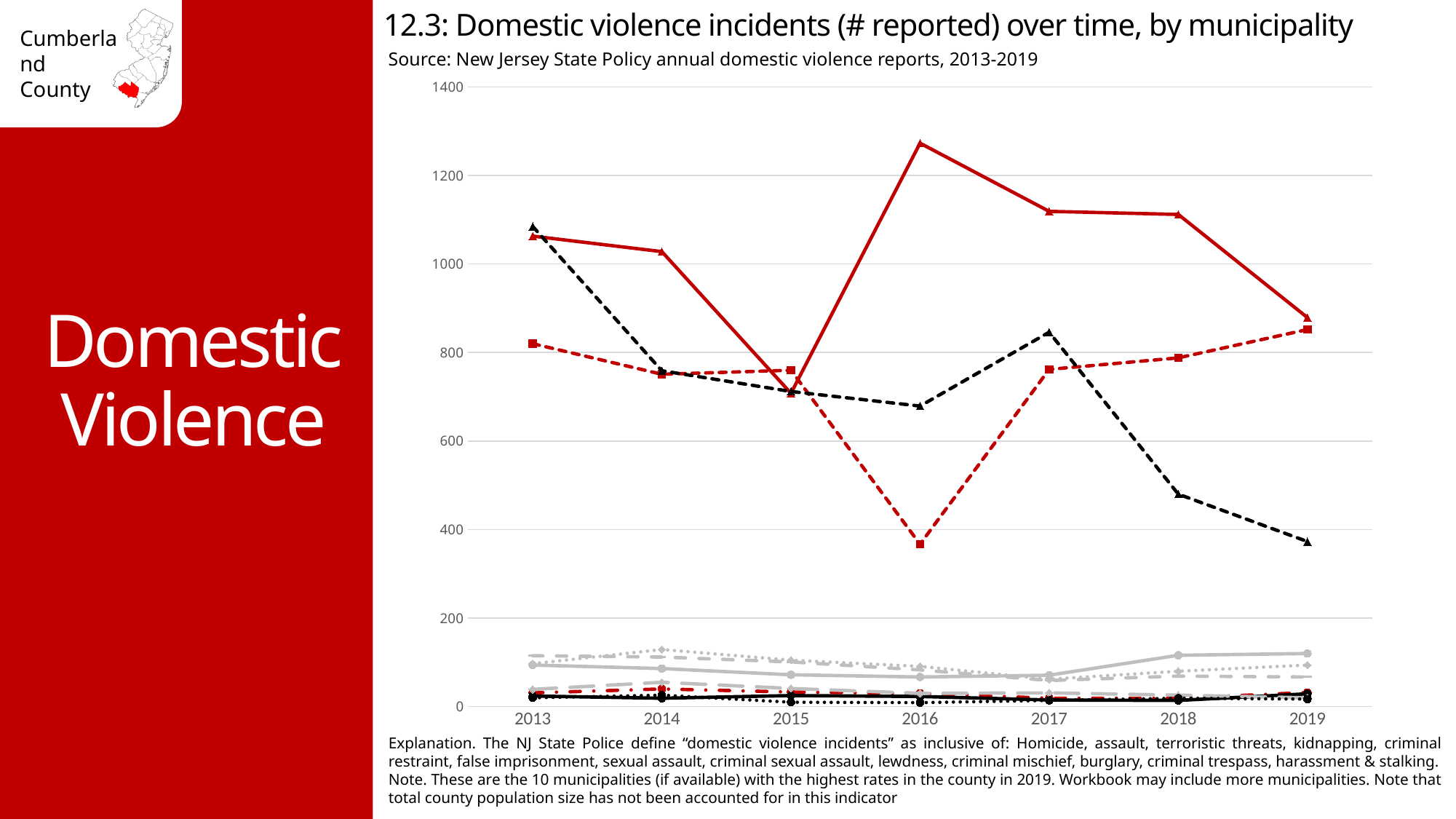
In 2017, which is larger: the solid red line with triangle markers or the black dashed line with triangle markers? the solid red line with triangle markers What is the highest value shown on the chart's y axis? 1400 Does the black dashed line with triangle markers rise or fall from 2017 to 2019? fall Does the red dashed line with square markers rise or fall from 2016 to 2019? rise What is the title of the chart on the slide? 12.3: Domestic violence incidents (# reported) over time, by municipality Is the value of the red dashed line with square markers in 2016 greater or less than 400? less In which year does the solid red line with triangle markers reach its highest value? 2016 Is the value of the solid red line with triangle markers in 2016 greater or less than 1200? greater Is the value of the black dashed line with triangle markers in 2019 greater or less than 400? less What kind of chart is shown on the slide? line chart How many years are plotted along the x axis of the chart? 7